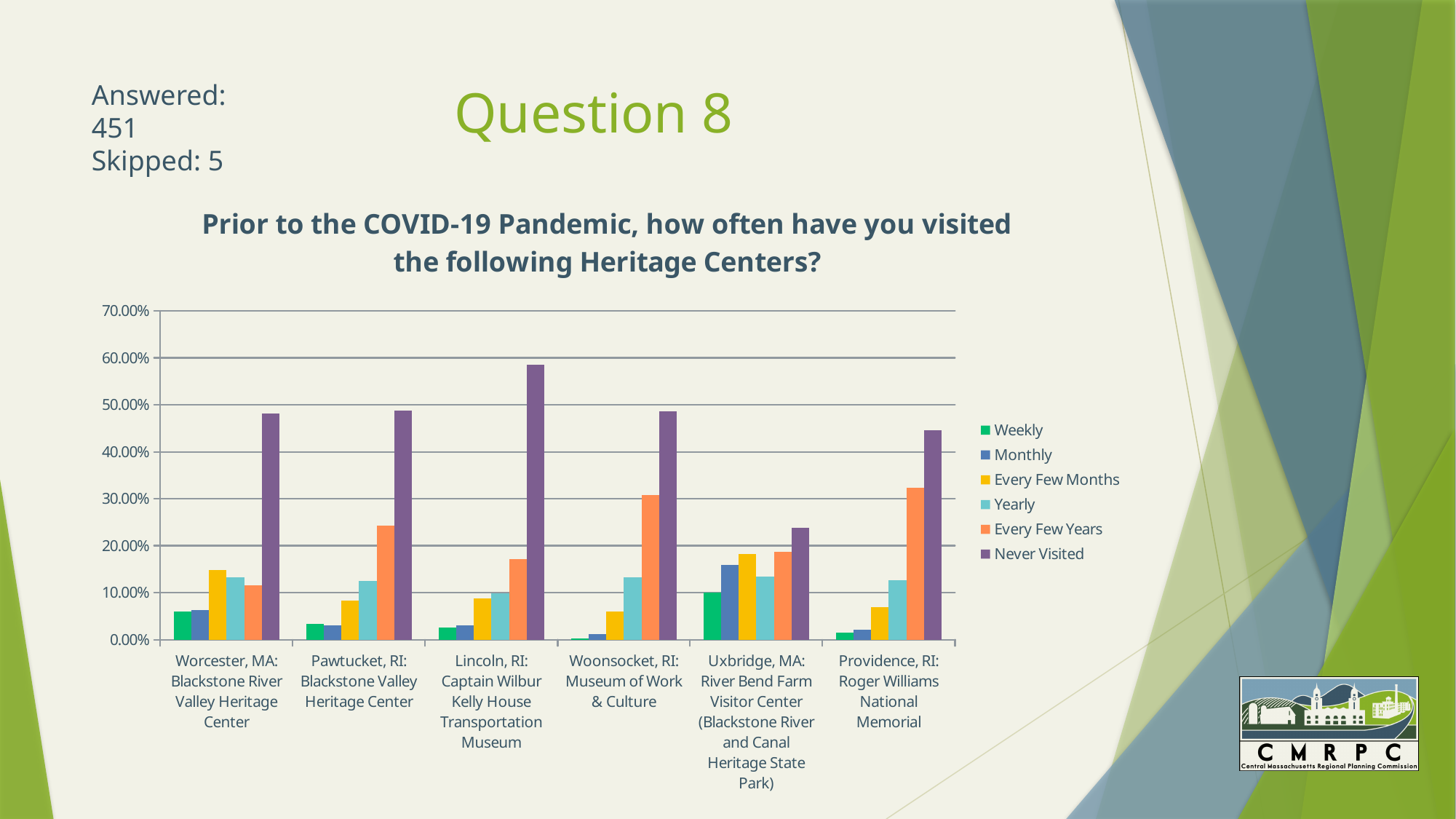
Which heritage center has the lowest "Never Visited" value? Uxbridge, MA: River Bend Farm Visitor Center (Blackstone River and Canal Heritage State Park) What kind of chart is shown on the slide? Bar chart Which heritage center has the highest "Weekly" value? Uxbridge, MA: River Bend Farm Visitor Center (Blackstone River and Canal Heritage State Park) How many heritage centers are shown along the x axis? 6 Which is larger: the "Weekly" value for Uxbridge, MA: River Bend Farm Visitor Center or for Worcester, MA: Blackstone River Valley Heritage Center? Uxbridge, MA: River Bend Farm Visitor Center How many series does the legend list? 6 Is the "Never Visited" value for Lincoln, RI: Captain Wilbur Kelly House Transportation Museum greater or less than 50.00%? greater Is the "Never Visited" value for Uxbridge, MA: River Bend Farm Visitor Center greater or less than 30.00%? less Which heritage center has the highest "Never Visited" value? Lincoln, RI: Captain Wilbur Kelly House Transportation Museum Is the "Every Few Years" value for Woonsocket, RI: Museum of Work & Culture greater or less than 20.00%? greater What colour represents the "Never Visited" series in the legend? Purple Which is larger: the "Every Few Years" value for Providence, RI: Roger Williams National Memorial or for Pawtucket, RI: Blackstone Valley Heritage Center? Providence, RI: Roger Williams National Memorial